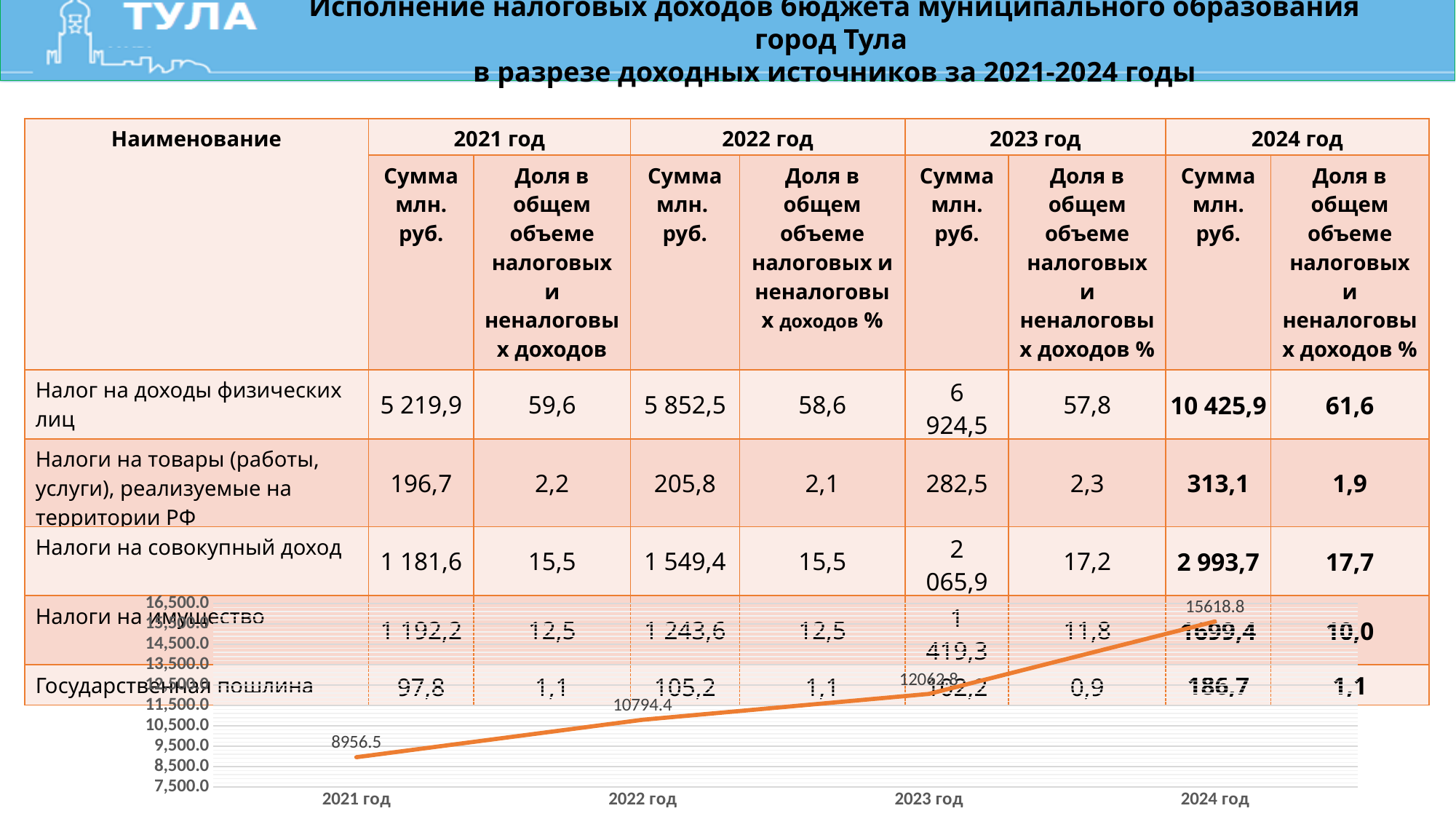
In the line chart, is the value for 2021 год greater or less than 9,500.0? less In the line chart, what is the value for 2024 год? 15618.8 In the line chart, which year has the lowest value? 2021 год In the line chart, what is the value for 2021 год? 8956.5 In the line chart, is the value for 2023 год larger than the value for 2022 год? yes In the line chart, what is the difference between the values for 2022 год and 2021 год? 1837.9 In the line chart, which year has the highest value? 2024 год How many data points are plotted in the line chart? 4 In the line chart, what is the difference between the values for 2024 год and 2021 год? 6662.3 In the line chart, what is the value for 2022 год? 10794.4 In the line chart, what is the value for 2023 год? 12062.8 What type of chart is shown at the bottom of the slide? line chart